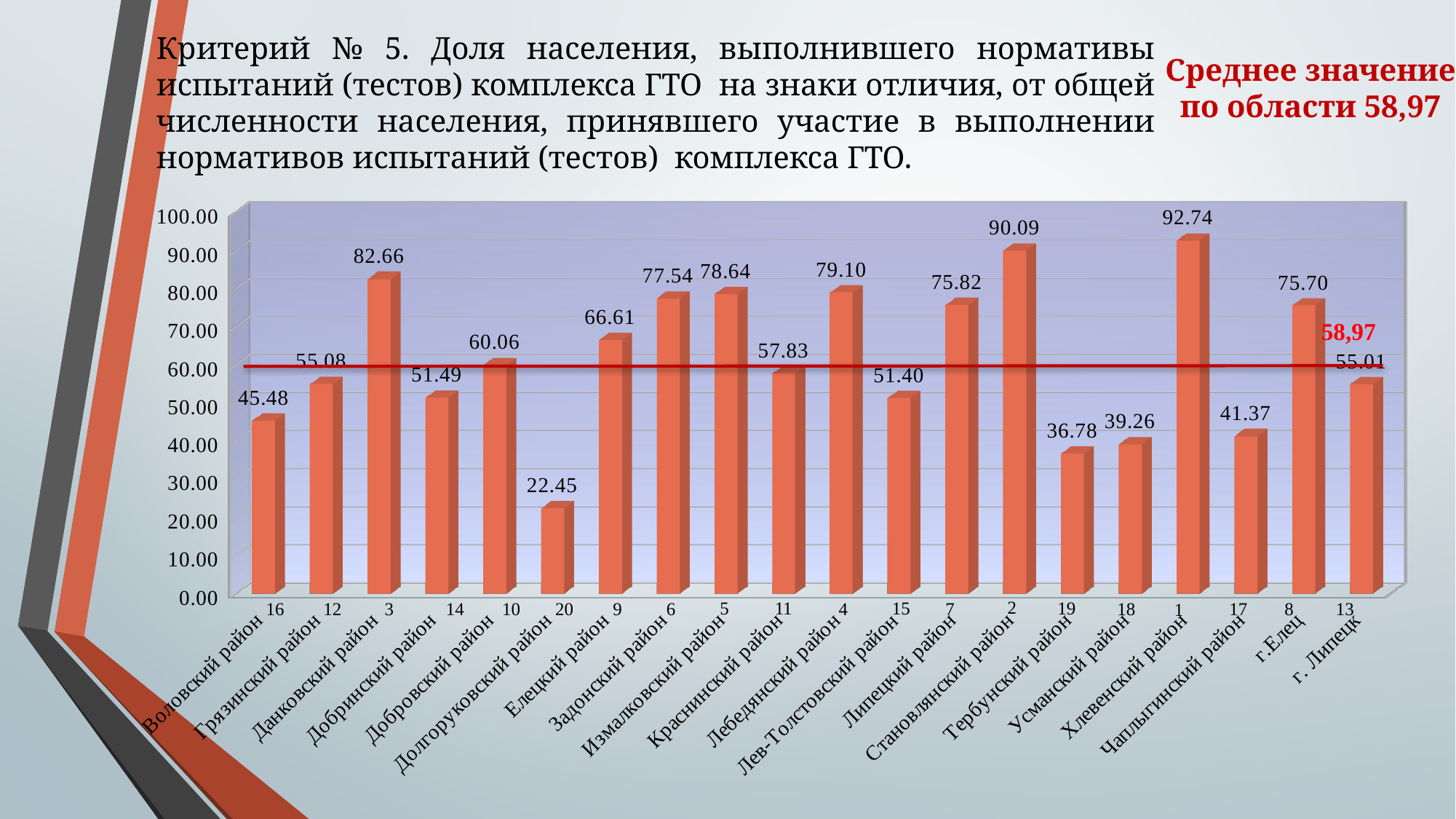
What is the difference between the values for Хлевенский район and Чаплыгинский район? 51.37 What is the value for Долгоруковский район? 22.45 Which district has the highest value on the chart? Хлевенский район Which district has the lowest value on the chart? Долгоруковский район What is the value for Данковский район? 82.66 What is the value for г. Липецк? 55.01 Is the value for Лебедянский район greater or less than 70.00? greater How many districts are shown on the chart? 20 What is the difference between the values for Становлянский район and Тербунский район? 53.31 Which is larger, the value for Задонский район or the value for Измалковский район? Измалковский район What kind of chart is shown on the slide? bar chart What value does the red horizontal line on the chart mark? 58,97